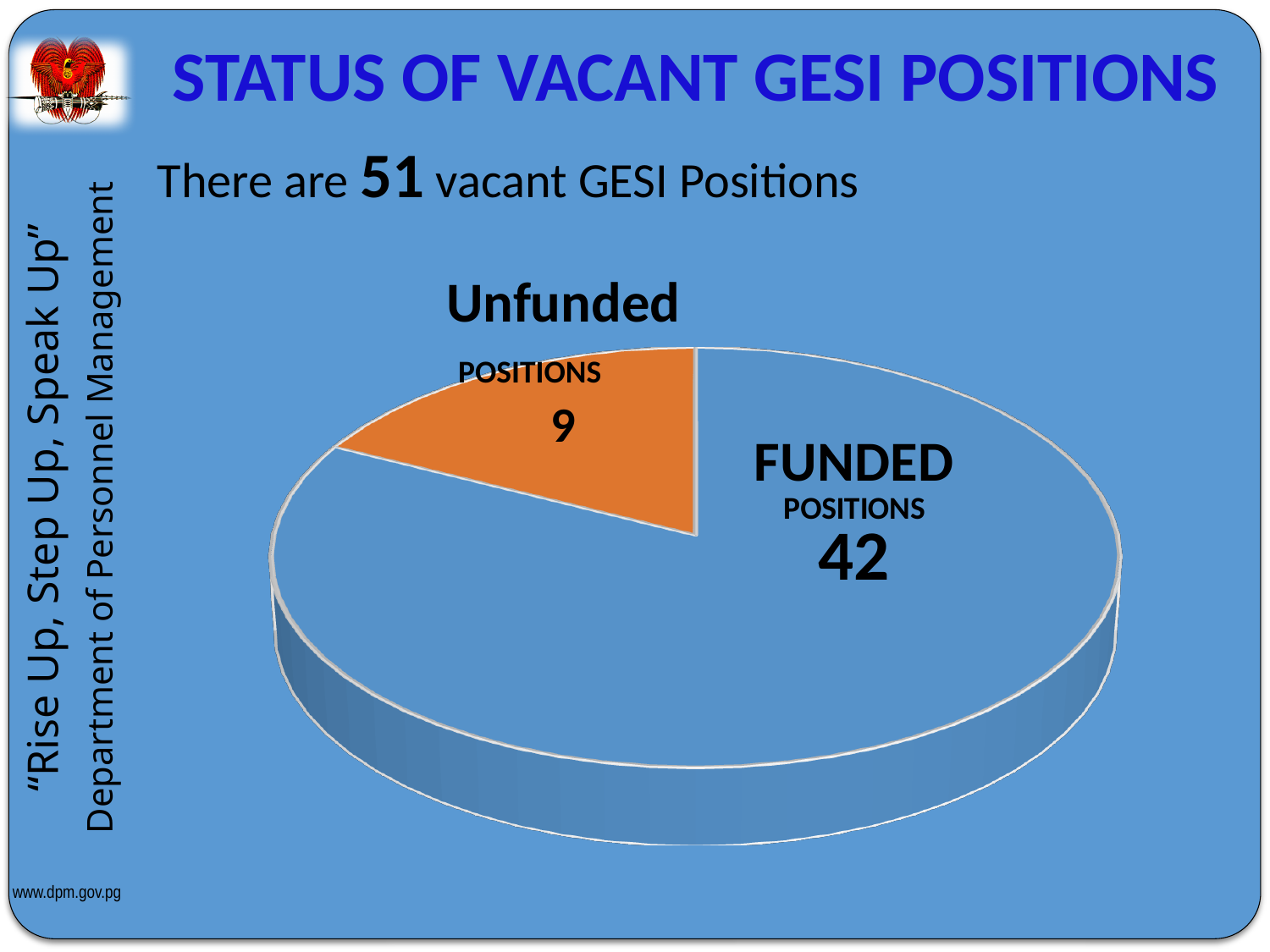
What is the title of the slide containing the pie chart? STATUS OF VACANT GESI POSITIONS How many funded positions are shown in the pie chart? 42 How many unfunded positions are shown in the pie chart? 9 What kind of chart is shown on the slide? pie chart What is the difference between the number of funded and unfunded positions? 33 Are there more funded or unfunded positions? Funded What colour is the slice for unfunded positions? orange What fraction of the total vacant positions are unfunded? 9 of 51 Which slice of the pie chart is the largest? Funded positions Which slice of the pie chart is the smallest? Unfunded positions What is the total number of positions represented in the pie chart? 51 How many slices does the pie chart have? 2